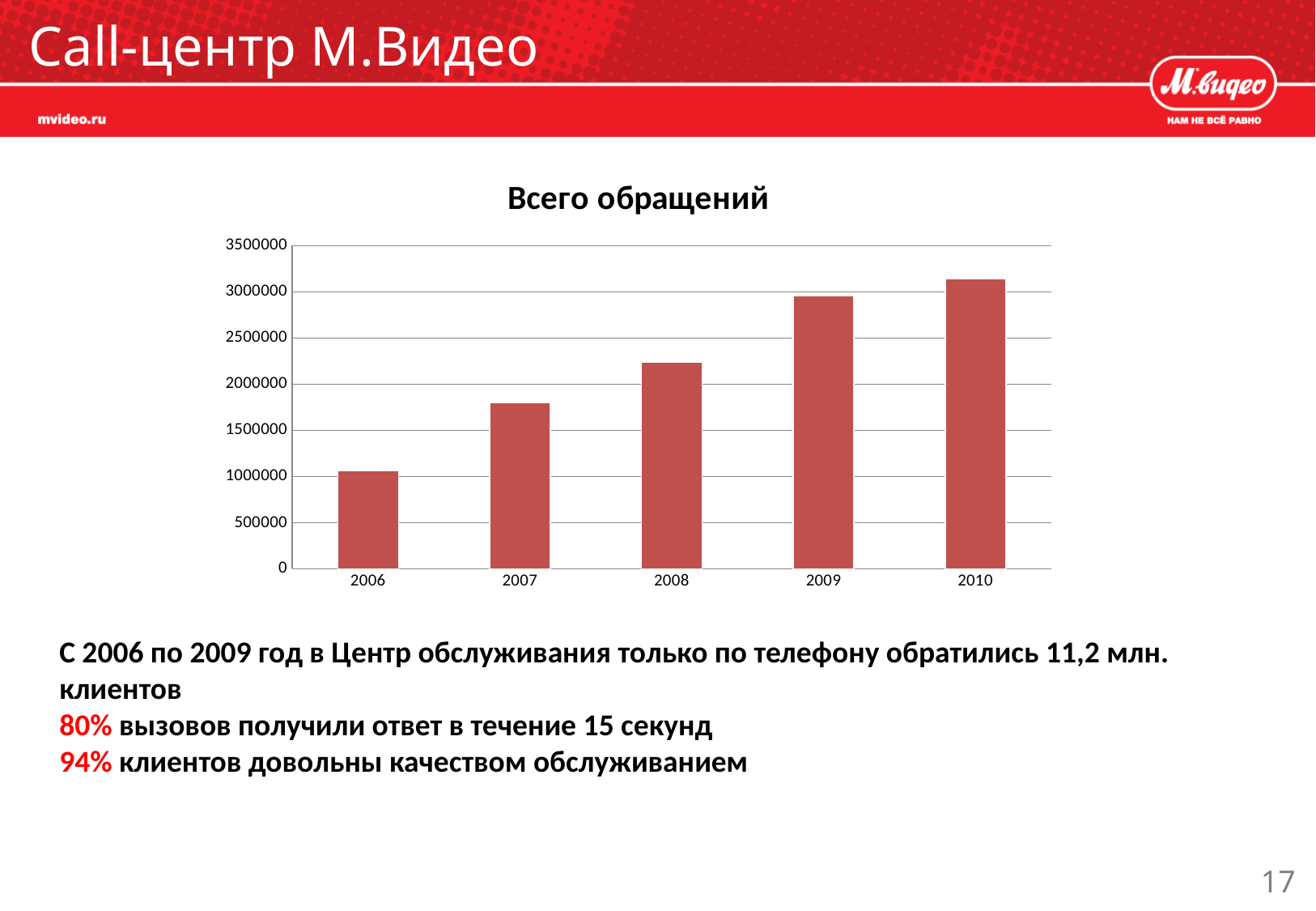
Is the value for 2010 greater or less than 3000000? greater Do the values rise or fall from 2006 to 2010? rise Which year has the highest value in the chart? 2010 Which year has the lowest value in the chart? 2006 Is the value for 2006 greater or less than 1500000? less How many years are shown on the x axis of the chart? 5 Is the value for 2009 greater or less than 2500000? greater What is the title of the chart? Всего обращений Which is larger, the value for 2008 or the value for 2007? 2008 What kind of chart is shown on the slide? bar chart